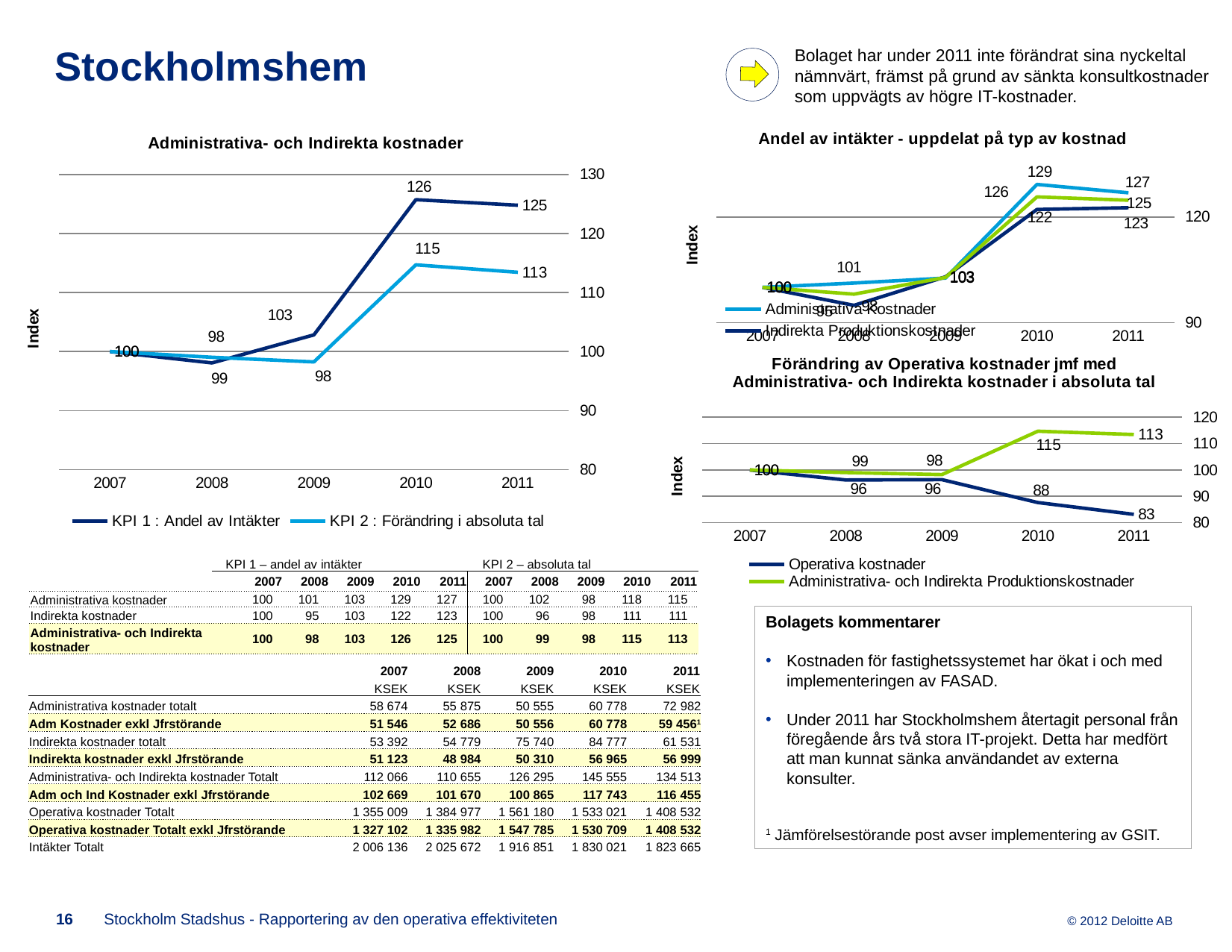
In the chart titled 'Förändring av Operativa kostnader jmf med Administrativa- och Indirekta kostnader i absoluta tal', what is the difference between Administrativa- och Indirekta Produktionskostnader and Operativa kostnader in 2010? 27 In the chart titled 'Administrativa- och Indirekta kostnader', what is the value of KPI 2 : Förändring i absoluta tal in 2011? 113 In the chart titled 'Administrativa- och Indirekta kostnader', how many years are shown on the x axis? 5 In the chart titled 'Administrativa- och Indirekta kostnader', what is the value of KPI 1 : Andel av Intäkter in 2010? 126 In the chart titled 'Andel av intäkter - uppdelat på typ av kostnad', what is the value of Administrativa kostnader in 2010? 129 What kind of chart is 'Administrativa- och Indirekta kostnader'? Line chart In the chart titled 'Förändring av Operativa kostnader jmf med Administrativa- och Indirekta kostnader i absoluta tal', what is the value of Operativa kostnader in 2011? 83 In the chart titled 'Andel av intäkter - uppdelat på typ av kostnad', which is larger in 2011: Administrativa kostnader or Indirekta Produktionskostnader? Administrativa kostnader In the chart titled 'Administrativa- och Indirekta kostnader', in which year is KPI 1 : Andel av Intäkter lowest? 2008 In the chart titled 'Administrativa- och Indirekta kostnader', what is the difference between KPI 1 and KPI 2 in 2011? 12 In the chart titled 'Administrativa- och Indirekta kostnader', how many series does the legend list? 2 In the chart titled 'Förändring av Operativa kostnader jmf med Administrativa- och Indirekta kostnader i absoluta tal', does the Operativa kostnader line rise or fall from 2007 to 2011? Fall